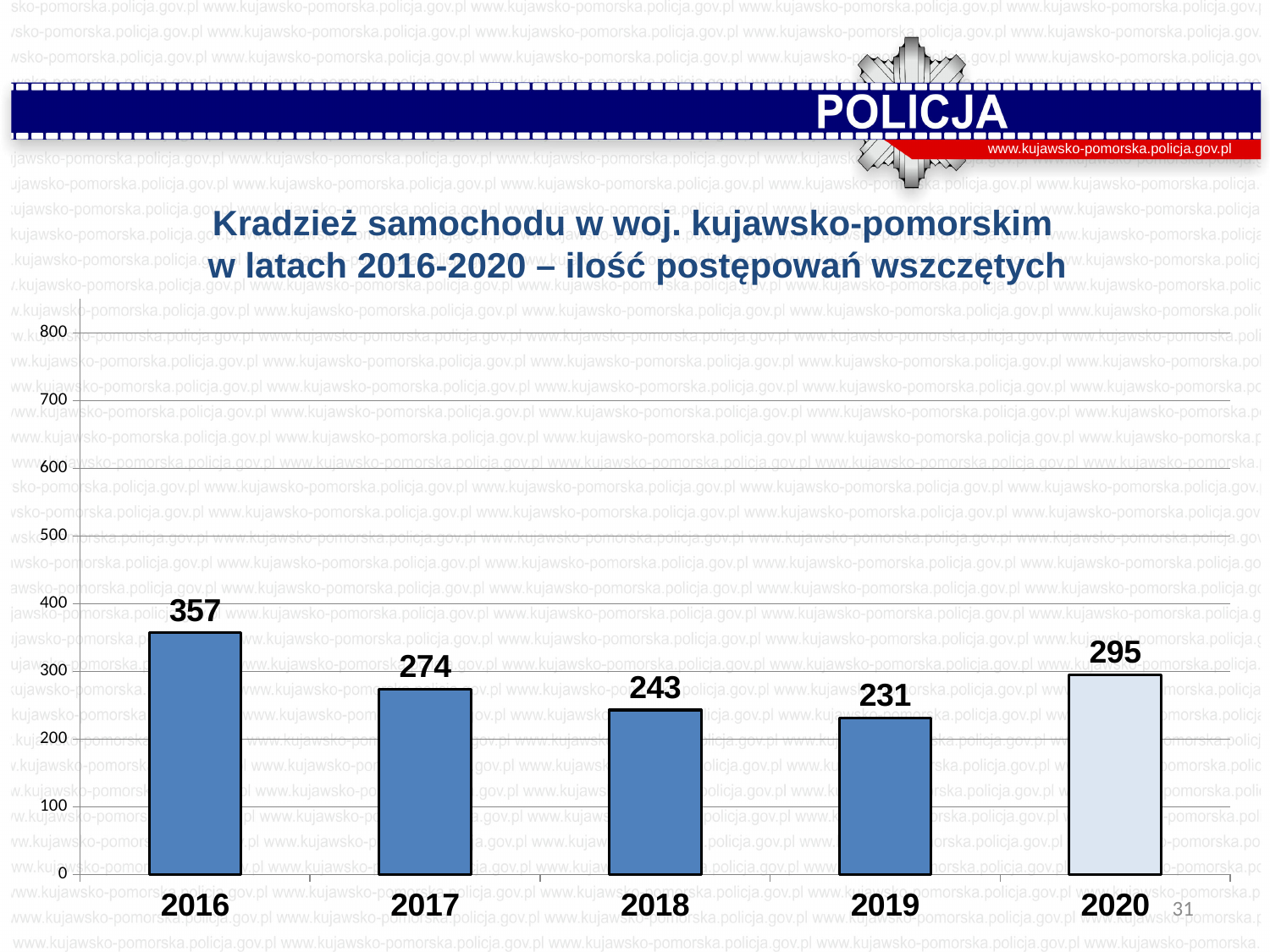
Which year has the lowest value? 2019 Is the value for 2017 greater or less than 300? less How many years are shown on the chart? 5 What is the value for 2019? 231 What is the difference between the values for 2016 and 2017? 83 Which year has the highest value? 2016 Which is larger, the value for 2018 or the value for 2020? 2020 Do the values rise or fall from 2016 to 2019? fall What is the difference between the values for 2020 and 2019? 64 What is the value for 2020? 295 What kind of chart is shown on the slide? bar chart What is the value for 2016? 357